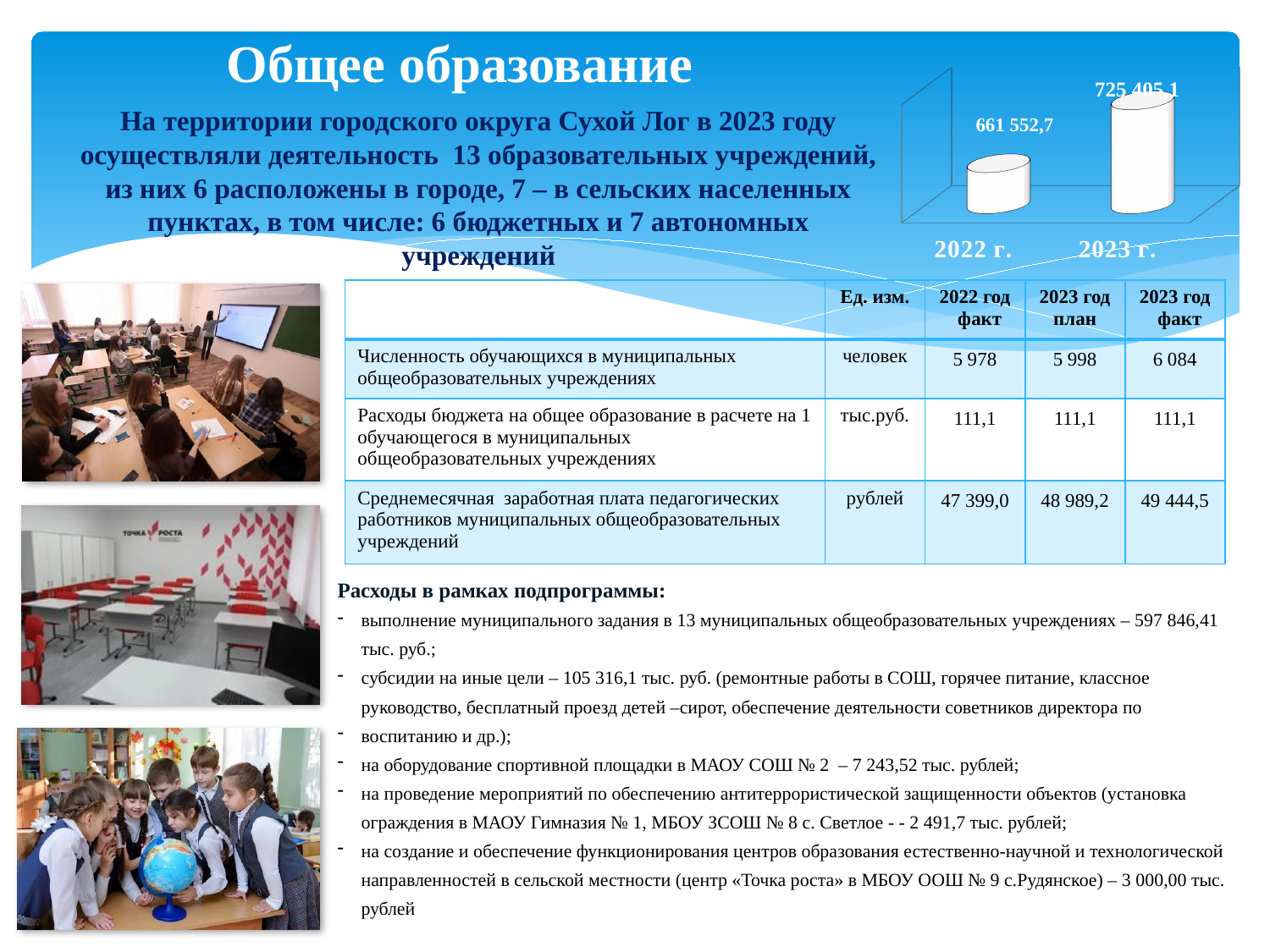
What is the value shown for 2023 г. in the chart? 725 405,1 What kind of chart is shown in the top right of the slide? bar chart Which year has the higher value in the chart? 2023 г. Is the value for 2023 г. larger or smaller than the value for 2022 г.? larger What are the two category labels on the chart's x axis? 2022 г. and 2023 г. By how much does the value for 2023 г. exceed the value for 2022 г.? 63 852,4 Which year has the lower value in the chart? 2022 г. How many bars are plotted in the chart? 2 Does the value rise or fall from 2022 г. to 2023 г.? rise What is the value shown for 2022 г. in the chart? 661 552,7